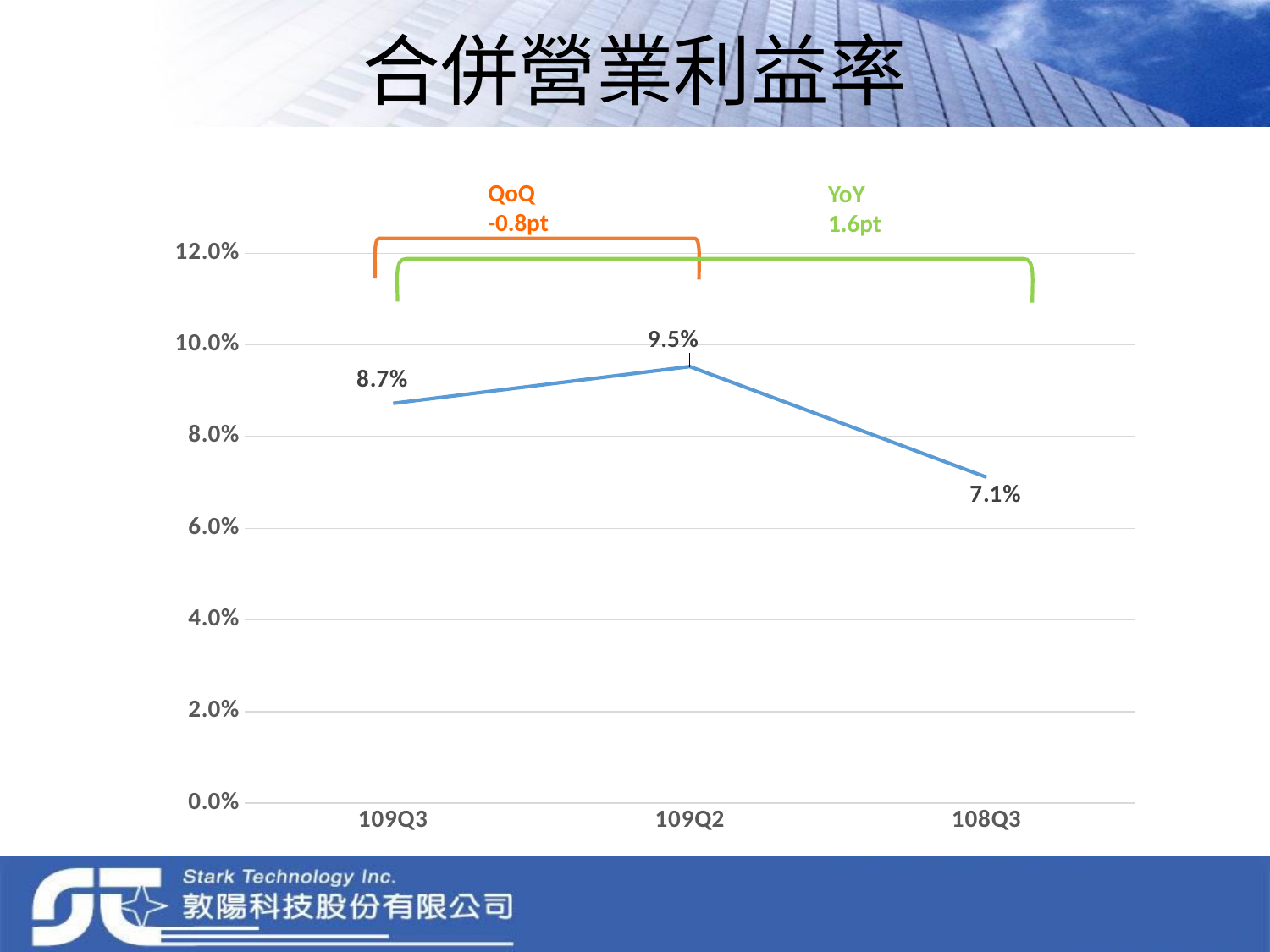
What QoQ change is annotated on the chart? -0.8pt What is the difference between the values for 109Q2 and 109Q3? 0.8% What is the value for 108Q3? 7.1% Which period has the highest value? 109Q2 Is the value for 108Q3 greater or less than 8.0%? less How many periods are plotted on the chart? 3 What is the difference between the values for 109Q3 and 108Q3? 1.6% What kind of chart is shown on the slide? line chart Which period has the lowest value? 108Q3 Which is larger, the value for 109Q3 or the value for 108Q3? 109Q3 What is the value for 109Q2? 9.5% What is the value for 109Q3? 8.7%